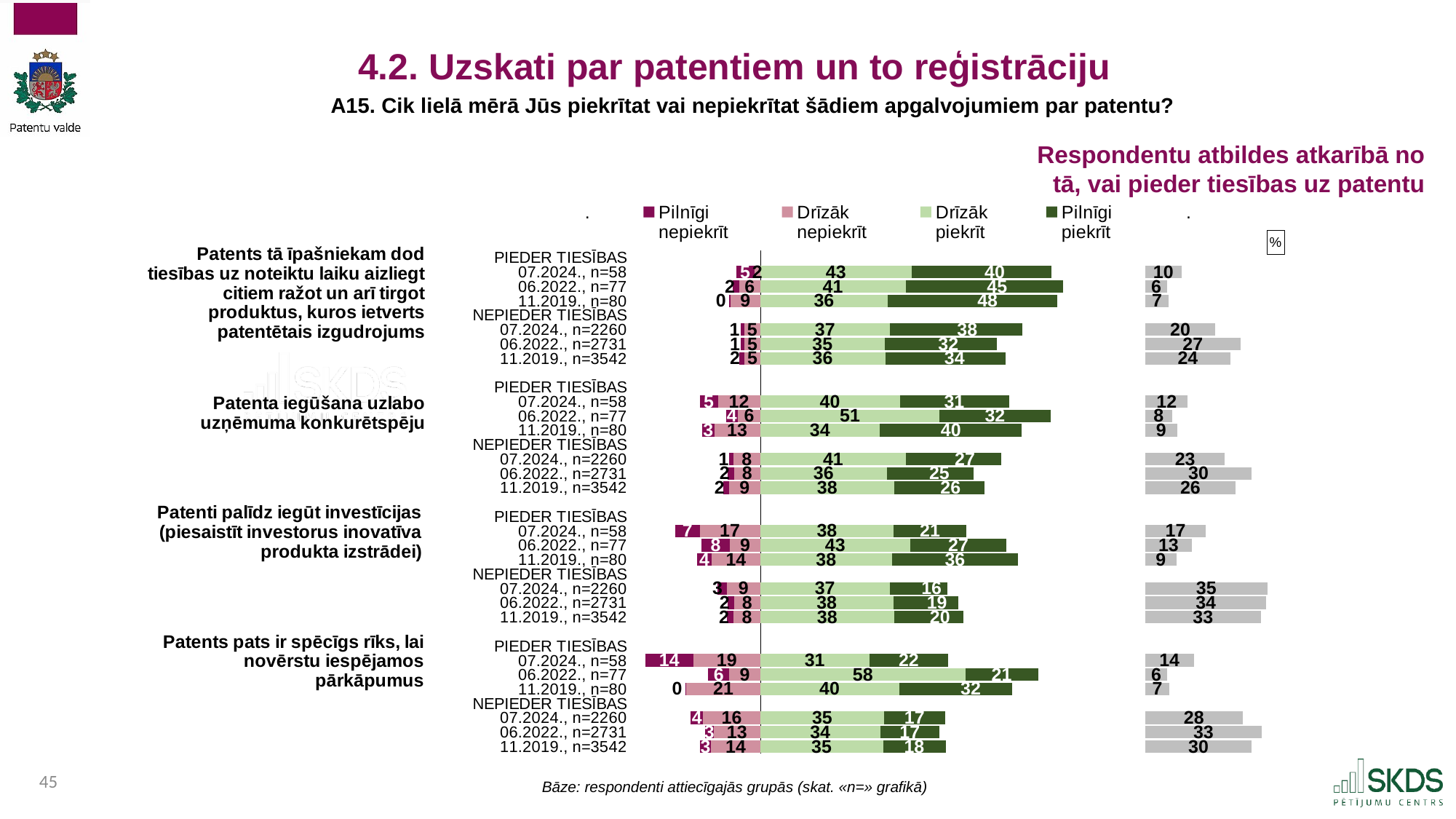
For the statement 'Patenta iegūšana uzlabo uzņēmuma konkurētspēju', what is the 'Drīzāk piekrīt' value for PIEDER TIESĪBAS, 06.2022., n=77? 51 For the statement 'Patents tā īpašniekam dod tiesības uz noteiktu laiku aizliegt citiem ražot...', what is the 'Pilnīgi piekrīt' value for PIEDER TIESĪBAS, 11.2019., n=80? 48 For the statement 'Patents pats ir spēcīgs rīks, lai novērstu iespējamos pārkāpumus', what is the 'Pilnīgi nepiekrīt' value for PIEDER TIESĪBAS, 07.2024., n=58? 14 For the statement 'Patents tā īpašniekam dod tiesības...', which is larger: the 'Pilnīgi piekrīt' value for NEPIEDER TIESĪBAS 07.2024., n=2260 or for NEPIEDER TIESĪBAS 06.2022., n=2731? 07.2024., n=2260 For the statement 'Patenta iegūšana uzlabo uzņēmuma konkurētspēju', what is the total of the four stacked segments for PIEDER TIESĪBAS, 07.2024., n=58? 88 For the statement 'Patenti palīdz iegūt investīcijas', what is the 'Pilnīgi piekrīt' value for NEPIEDER TIESĪBAS, 07.2024., n=2260? 16 For the statement 'Patenti palīdz iegūt investīcijas', what is the difference between the 'Pilnīgi piekrīt' values for PIEDER TIESĪBAS 11.2019., n=80 and 07.2024., n=58? 15 What kind of chart is shown on the slide? stacked bar chart Which legend entry is shown in the darkest green colour? Pilnīgi piekrīt For the statement 'Patents pats ir spēcīgs rīks, lai novērstu iespējamos pārkāpumus', what is the value of the grey bar on the right for NEPIEDER TIESĪBAS, 06.2022., n=2731? 33 For the statement 'Patents pats ir spēcīgs rīks, lai novērstu iespējamos pārkāpumus', which row has the highest 'Drīzāk piekrīt' value? PIEDER TIESĪBAS, 06.2022., n=77 How many series does the legend list? 4